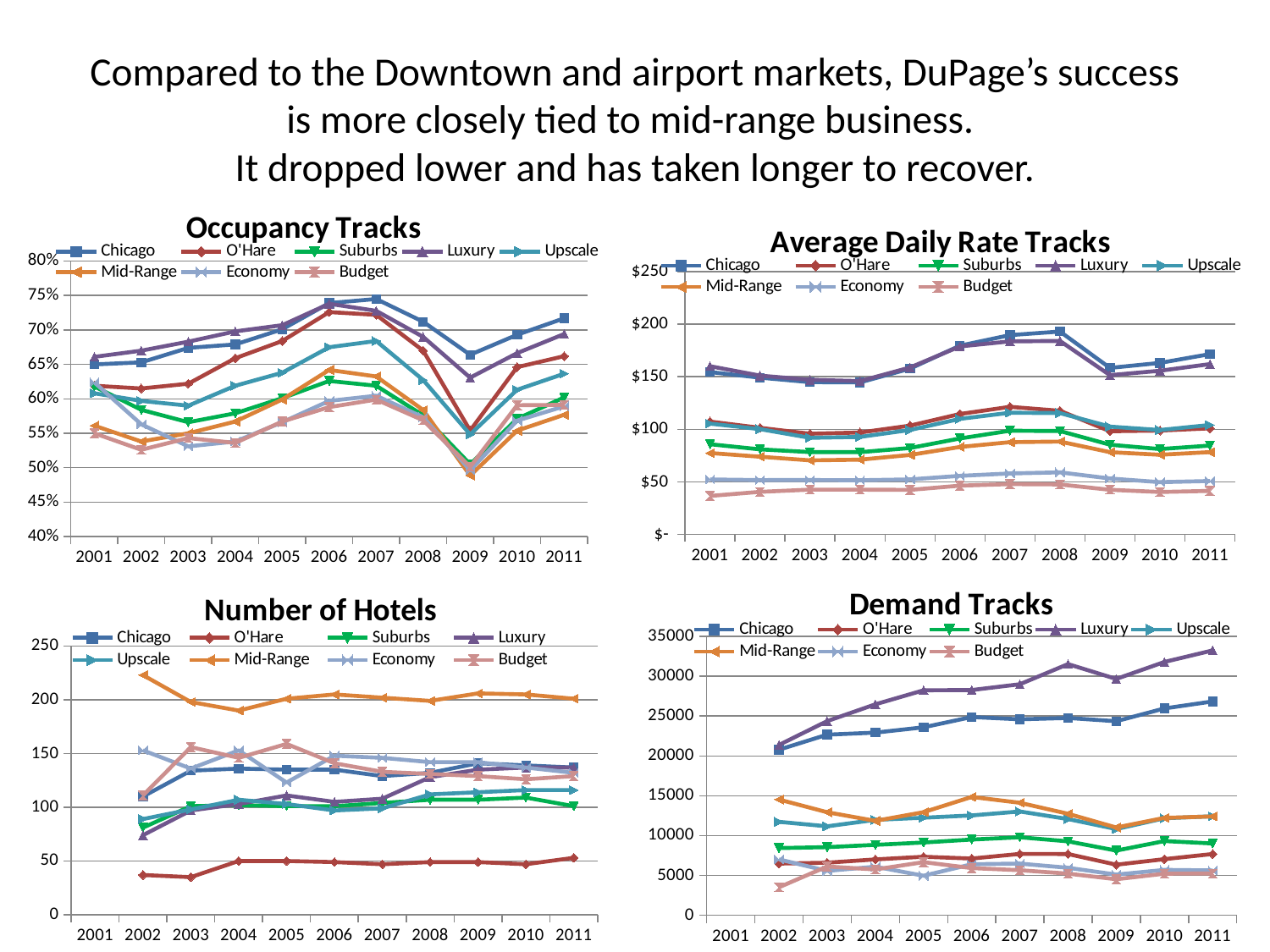
How many charts are on the slide? 4 In the Demand Tracks chart, do the values for Luxury generally rise or fall from 2002 to 2011? rise How many years are shown on the x axis of the Occupancy Tracks chart? 11 In the Demand Tracks chart, which is larger in 2011, Luxury or Chicago? Luxury In the Occupancy Tracks chart, is the value for Chicago in 2007 greater or less than 70%? greater In the Occupancy Tracks chart, which year has the lowest value for Mid-Range? 2009 In the Average Daily Rate Tracks chart, is the value for Budget in 2001 greater or less than $50? less In the Number of Hotels chart, which series has the highest values across all years? Mid-Range How many series does the legend of the Average Daily Rate Tracks chart list? 8 In the Average Daily Rate Tracks chart, is the value for Chicago in 2008 greater or less than $150? greater What type of chart is the Occupancy Tracks chart? line chart